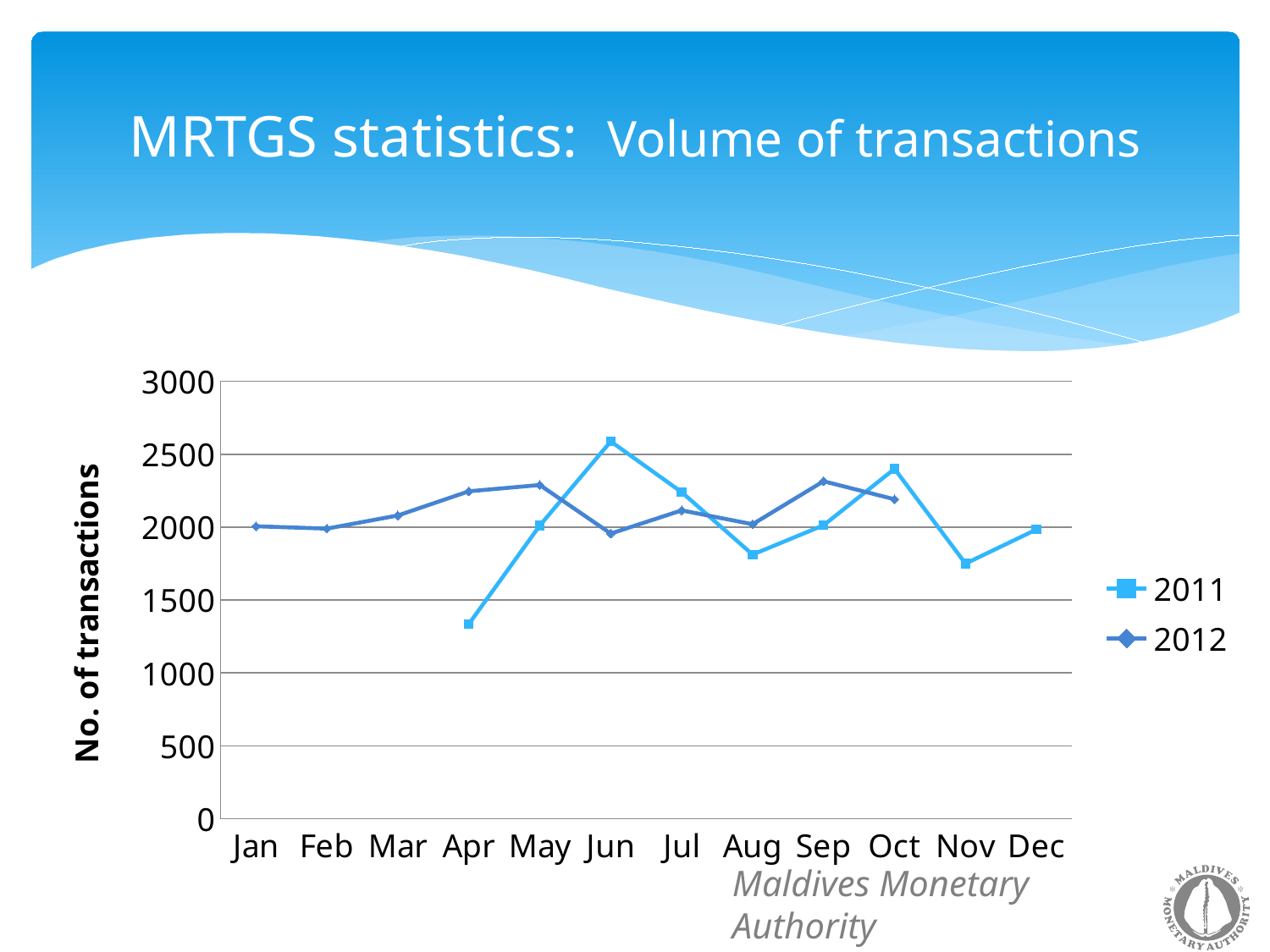
Which series has the larger value in Jun, 2011 or 2012? 2011 Is the value for 2011 in Aug greater or less than 2000? less Is the value for 2011 in Apr greater or less than 1500? less In which month does the 2011 series have its lowest value? Apr How many series does the legend list? 2 In which month does the 2011 series reach its highest value? Jun Is the value for 2011 in Jun greater or less than 2500? greater What is the label on the y axis? No. of transactions How many months are shown on the x axis? 12 Which series has the larger value in Apr, 2011 or 2012? 2012 What kind of chart is shown on the slide? line chart